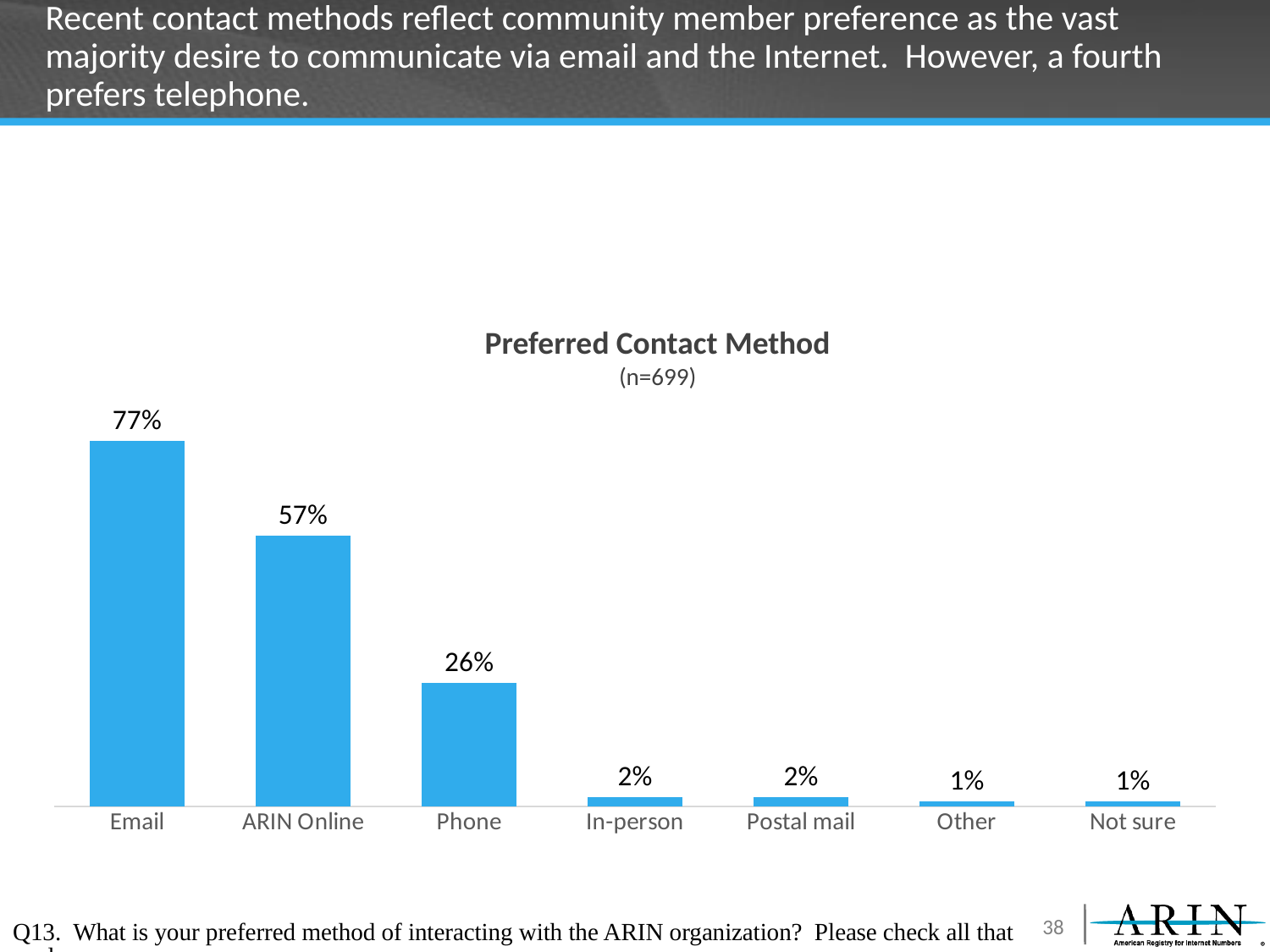
What is the value for Postal mail? 2% What is the difference between the Email and ARIN Online values? 20% What kind of chart is shown on the slide? Bar chart What is the value shown for ARIN Online? 57% Which is larger, the value for Phone or the value for In-person? Phone How many contact method categories are shown on the chart? 7 What is the sample size (n) shown under the chart title? n=699 Do the values rise or fall moving from left to right across the categories? Fall What percentage of respondents prefer Email as a contact method? 77% What percentage prefers Phone? 26% Which contact method has the highest value? Email What is the difference between the ARIN Online and Phone values? 31%